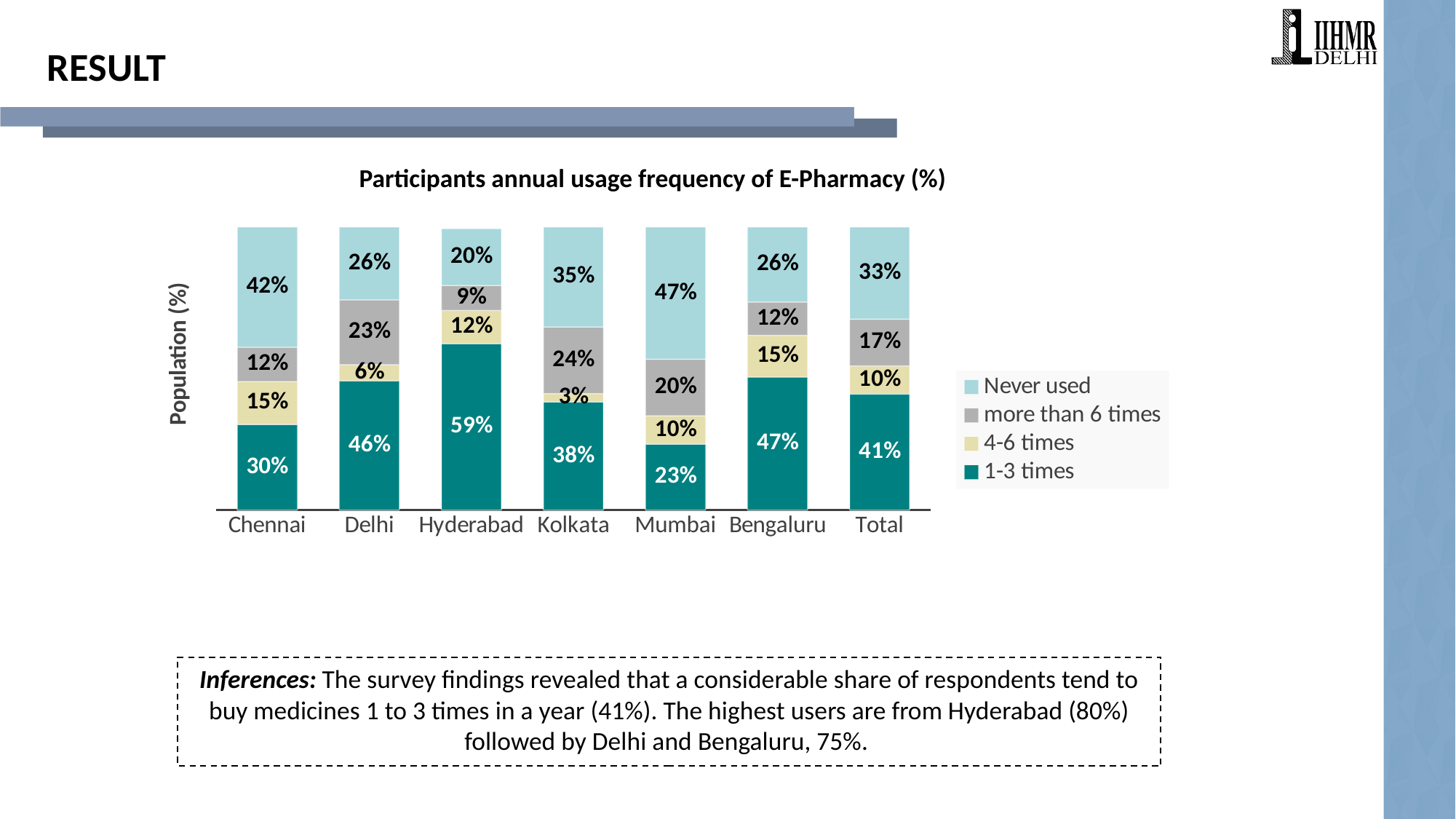
What percentage of participants in Hyderabad used E-Pharmacy 1-3 times? 59% What is the title of the chart? Participants annual usage frequency of E-Pharmacy (%) How many series does the legend list? 4 What is the 'Never used' value for Mumbai? 47% What kind of chart is shown on the slide? Stacked bar chart How many categories are shown on the x axis? 7 What percentage of Delhi participants used E-Pharmacy more than 6 times? 23% What is the difference between the 'Never used' percentages for Chennai and Delhi? 16% What is the 4-6 times value for Kolkata? 3% Which is larger: the 1-3 times value for Bengaluru or for Kolkata? Bengaluru Which city has the lowest 'Never used' percentage? Hyderabad Which city has the highest share of participants who used E-Pharmacy 1-3 times? Hyderabad